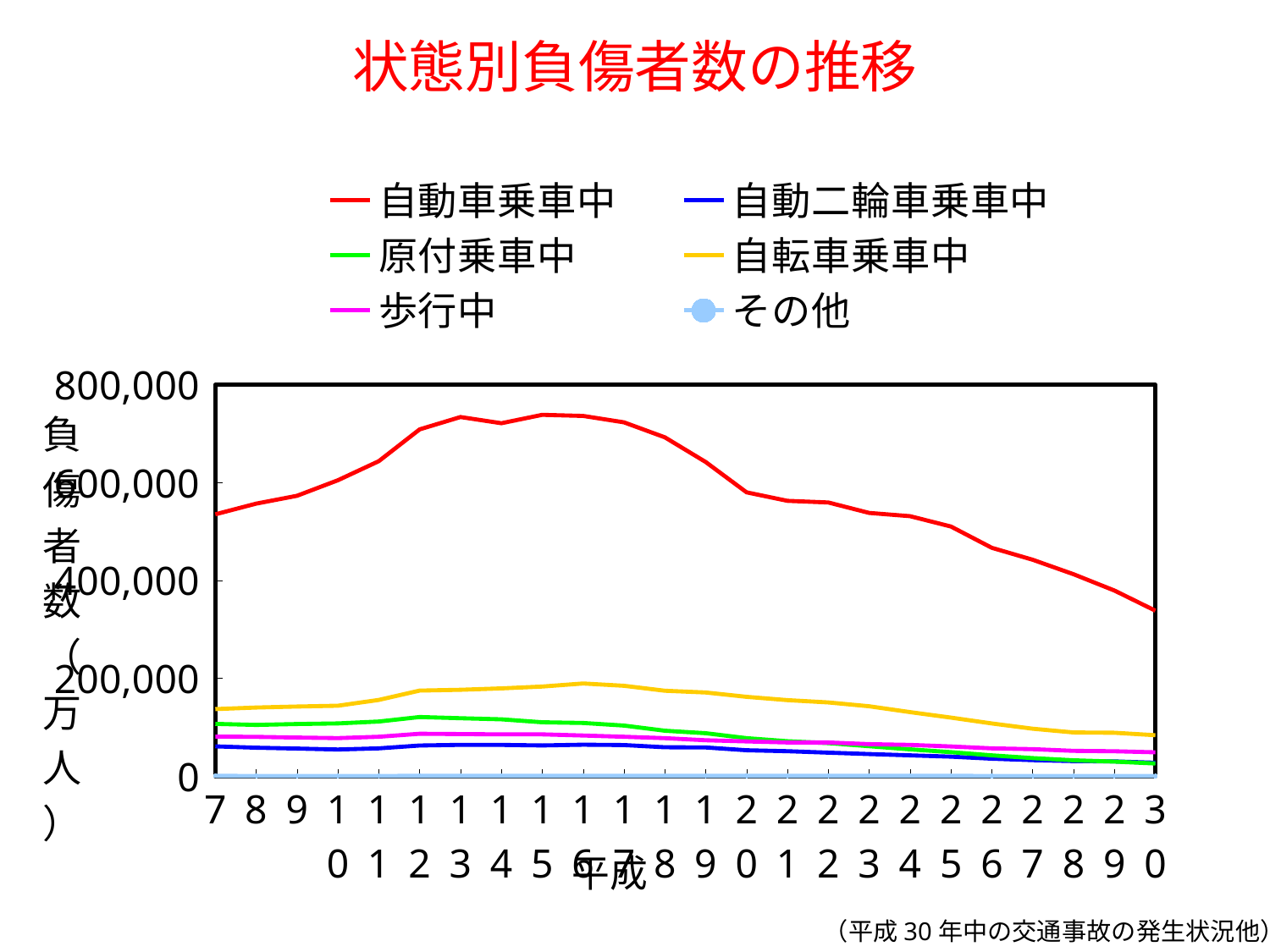
Which series has the lowest values throughout the chart? その他 What kind of chart is shown on the slide? line chart What colour is the 自動車乗車中 line in the legend? red In 平成30, which is larger: 自転車乗車中 or 原付乗車中? 自転車乗車中 Is the value for 自動車乗車中 in 平成30 greater or less than 400,000? less Is the value for 自転車乗車中 in 平成17 greater or less than 100,000? greater Is the value for 自動車乗車中 in 平成15 greater or less than 600,000? greater What is the title of the chart? 状態別負傷者数の推移 Does the 自動車乗車中 line rise or fall from 平成16 to 平成30? fall Which series has the highest values throughout the chart? 自動車乗車中 How many series does the legend list? 6 How many years (points) are shown along the x axis? 24